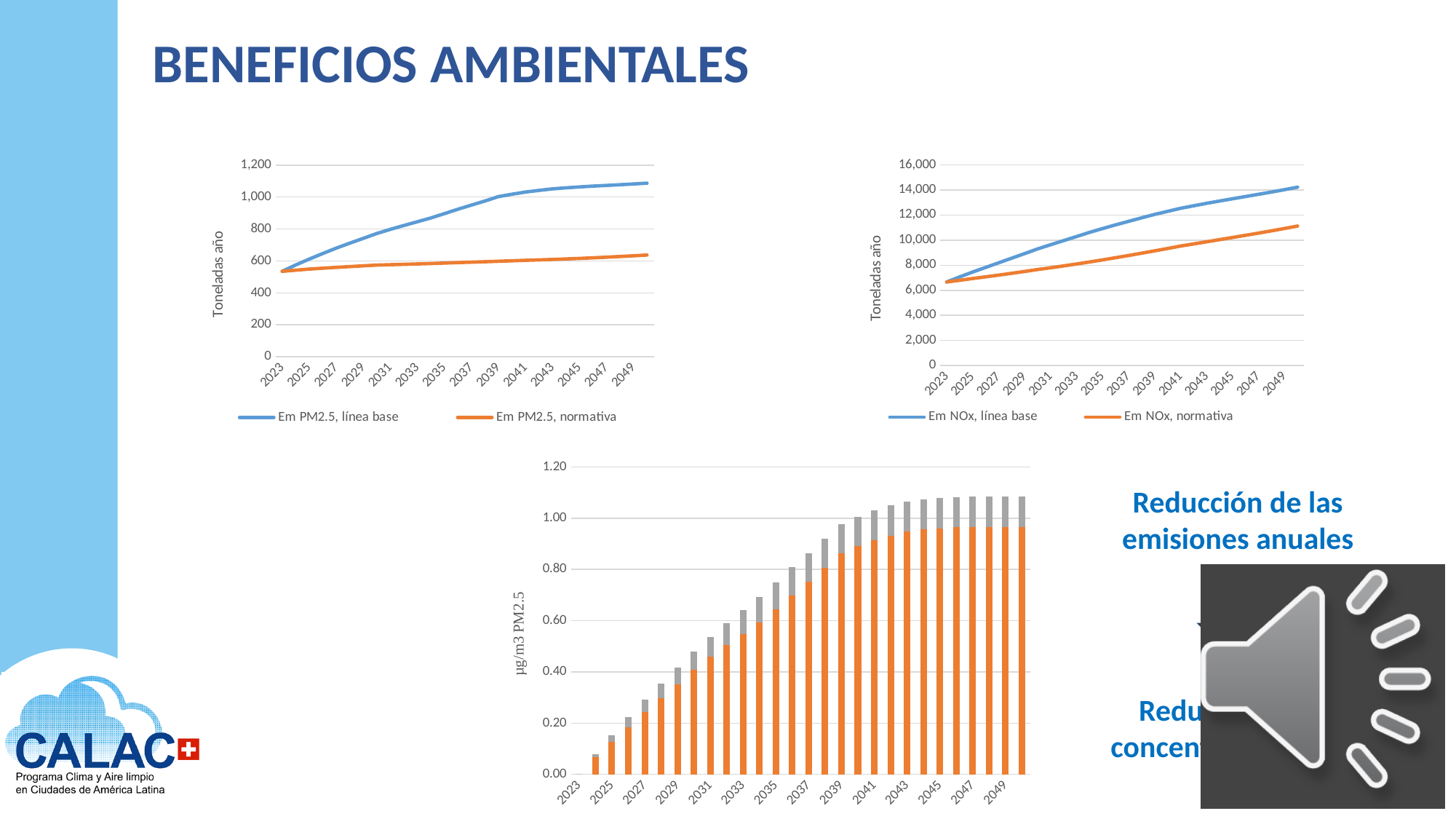
In the top-right chart, do the values of Em NOx, línea base rise or fall from 2023 to 2049? rise In the bottom chart, is the total bar value for 2023 greater or less than 0.20? less In the top-right chart, is the value for Em NOx, línea base in 2049 greater or less than 12,000? greater What kind of chart is the bottom chart on the slide? Bar chart How many series does the legend of the top-left chart list? 2 In the top-left chart, is the value for Em PM2.5, normativa in 2049 greater or less than 800? less What kind of chart is the top-left chart on the slide? Line chart What is the y-axis label of the bottom chart? µg/m3 PM2.5 In the top-right chart, what are the two legend entries? Em NOx, línea base; Em NOx, normativa In the top-left chart, which series has the larger value in 2049, Em PM2.5, línea base or Em PM2.5, normativa? Em PM2.5, línea base